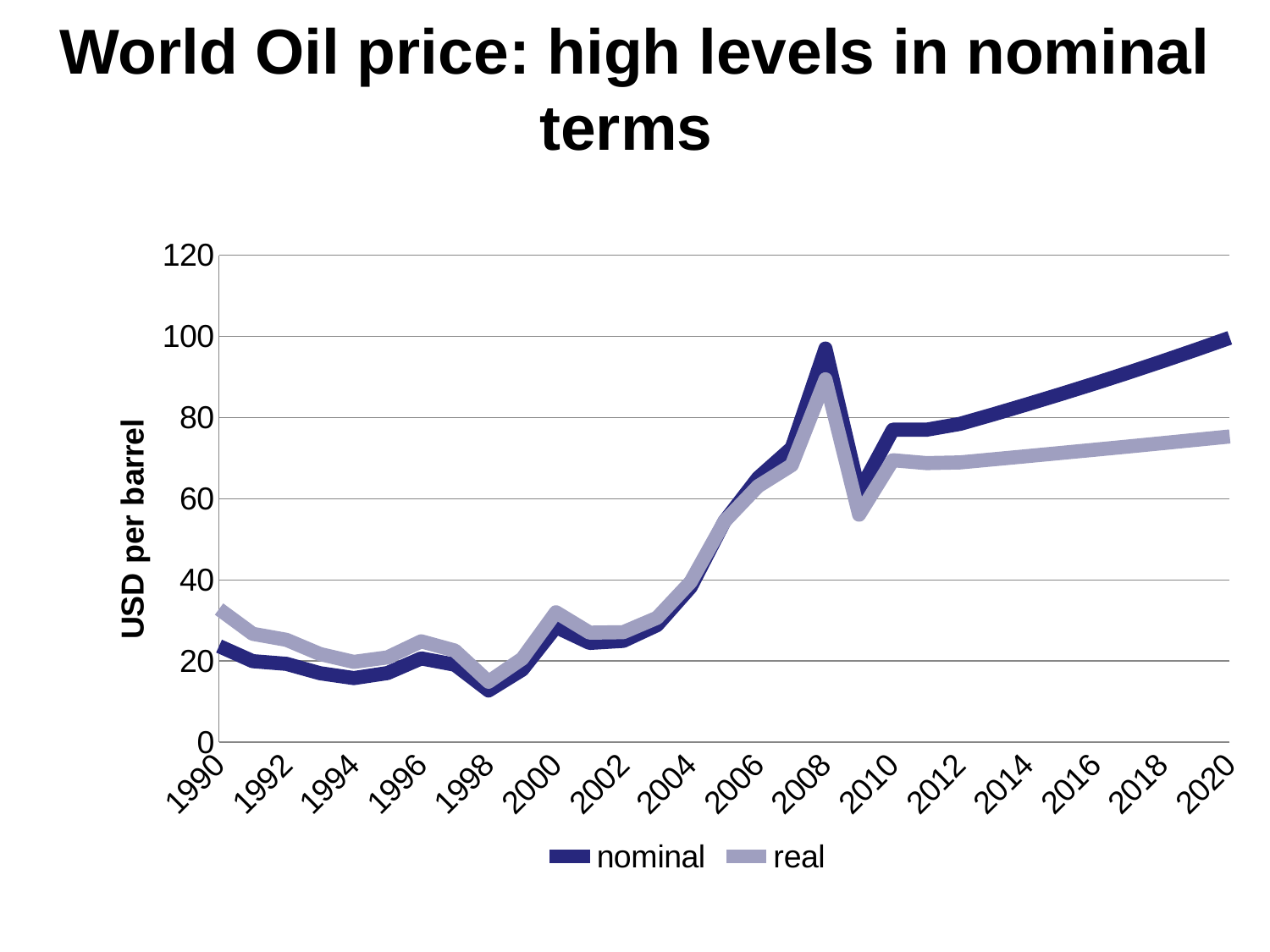
In which year does the nominal series reach its lowest value? 1998 Is the nominal value in 2008 greater or less than 80? greater What are the two series named in the legend? nominal and real Does the nominal series rise or fall between 2010 and 2020? rise What is the label on the vertical axis? USD per barrel How many series does the legend list? 2 Is the real value in 2020 greater or less than 80? less What kind of chart is shown on the slide? line chart Is the nominal value in 1998 greater or less than 20? less In 1990, which series has the higher value, nominal or real? real In which year does the nominal series reach its highest value? 2020 In 2020, which series has the higher value, nominal or real? nominal